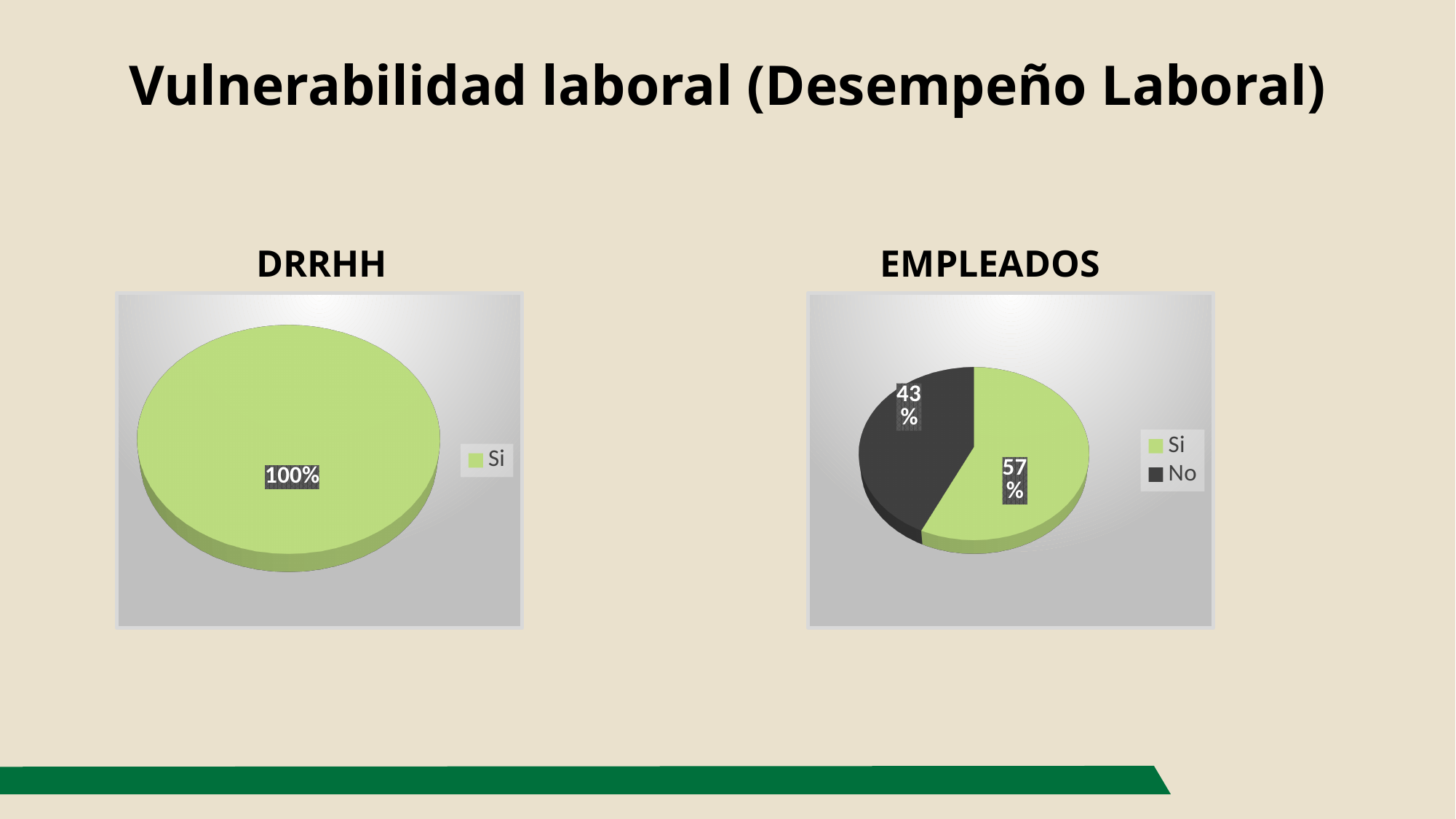
In the EMPLEADOS chart, what is the difference in percentage points between "Si" and "No"? 14 In the EMPLEADOS chart, what colour is the "No" slice? Dark grey In the DRRHH chart, what share of the pie does "Si" take? 100% How many slices does the DRRHH pie chart have? 1 What kind of chart is the EMPLEADOS chart? Pie chart In the EMPLEADOS chart, what share of the pie does "Si" take? 57% In the EMPLEADOS chart, which is larger, "Si" or "No"? Si How many entries does the legend of the EMPLEADOS chart list? 2 What kind of chart is the DRRHH chart? Pie chart In the EMPLEADOS chart, what share of the pie does "No" take? 43% In the EMPLEADOS chart, which slice is the smallest? No In the EMPLEADOS chart, which slice is the largest? Si